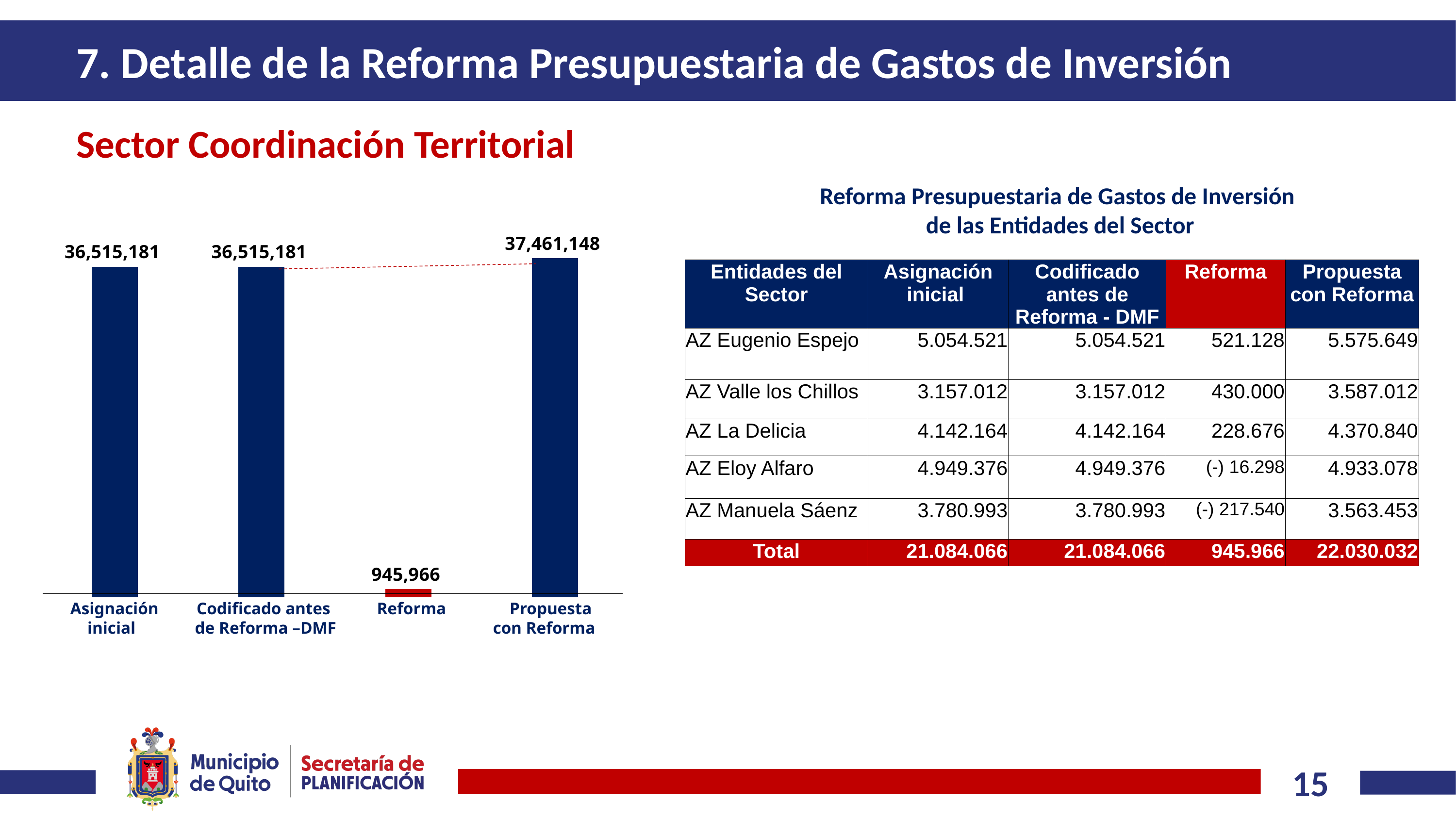
Which category has the lowest value in the chart? Reforma What is the value of the Reforma bar in the chart? 945,966 What colour is the Reforma bar in the chart? Red What is the value of the Asignación inicial bar in the chart? 36,515,181 Do the Asignación inicial and Codificado antes de Reforma –DMF bars have the same value? Yes What type of chart is shown on the slide? Bar chart How many bars are shown in the chart? 4 What is the value of the Propuesta con Reforma bar in the chart? 37,461,148 Which category has the highest value in the chart? Propuesta con Reforma Which is larger in the chart, Propuesta con Reforma or Asignación inicial? Propuesta con Reforma What is the difference between the Propuesta con Reforma bar and the Codificado antes de Reforma –DMF bar? 945,967 What is the value of the Codificado antes de Reforma –DMF bar in the chart? 36,515,181